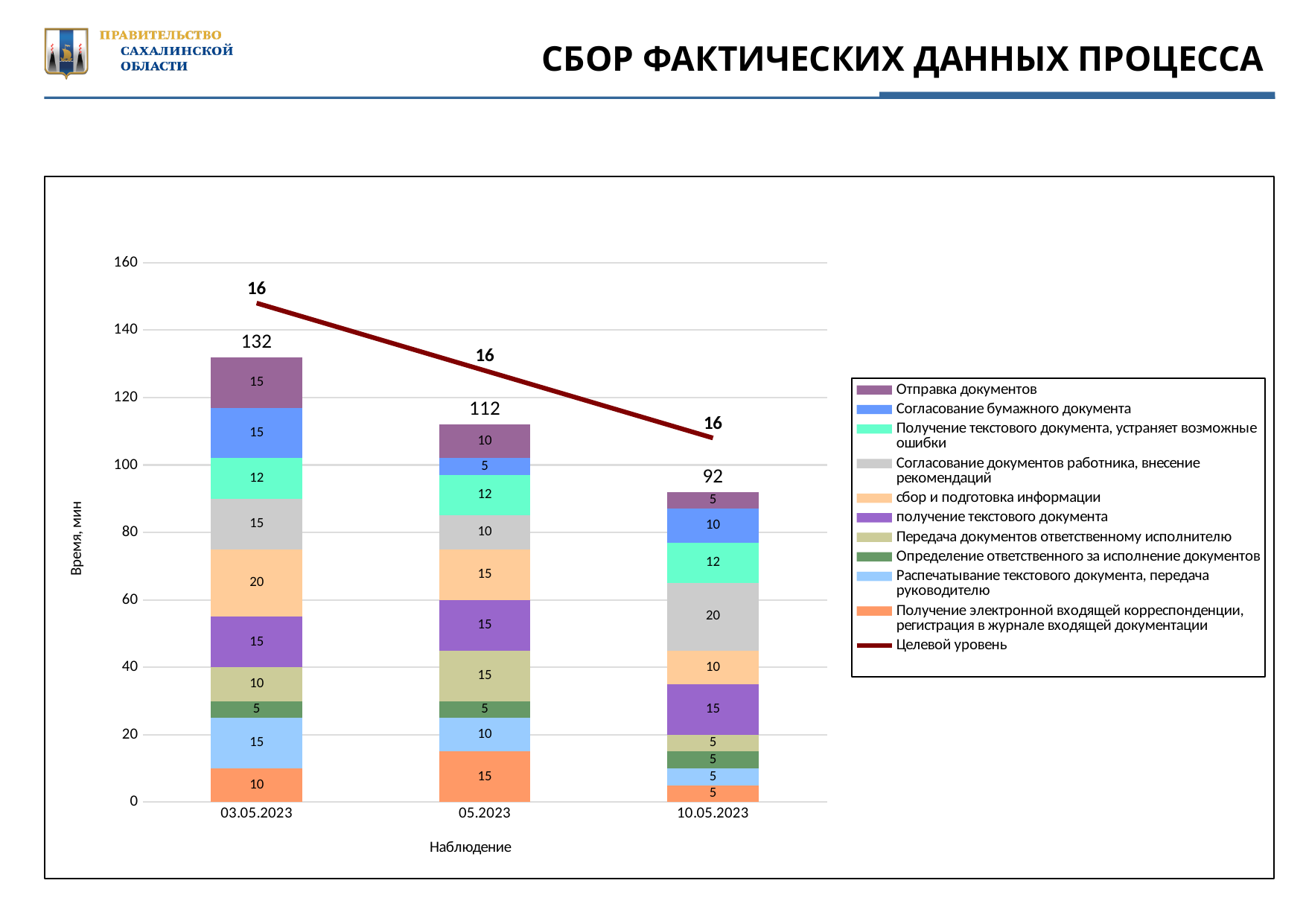
What is the total value shown above the bar for 03.05.2023? 132 What is the total value shown above the bar for 10.05.2023? 92 What is the value of the 'Согласование документов работника, внесение рекомендаций' segment for 10.05.2023? 20 Which observation has the lowest total bar? 10.05.2023 How many entries does the legend list? 11 Do the total bar values rise or fall from 03.05.2023 to 10.05.2023? fall Which observation has the highest total bar? 03.05.2023 What is the difference between the total for 03.05.2023 and the total for 10.05.2023? 40 What kind of chart is shown on the slide? stacked bar chart with a line (combination chart) What is the title of the y axis? Время, мин How many observations (categories) are shown on the x axis? 3 What is the value of the 'сбор и подготовка информации' segment for 03.05.2023? 20